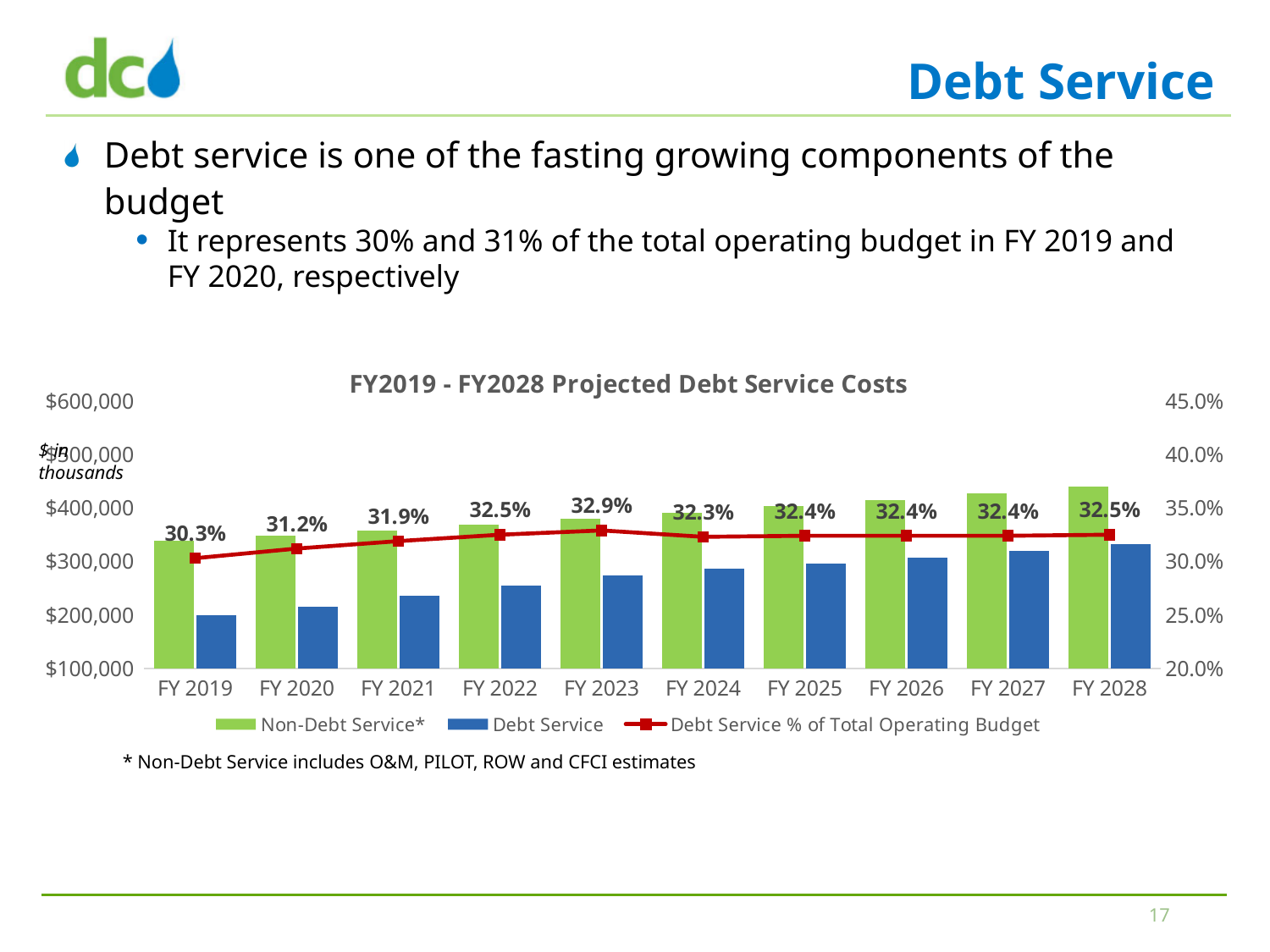
How many fiscal years are shown on the x axis of the chart? 10 What is the difference in Debt Service % of Total Operating Budget between FY 2023 and FY 2019? 2.6 percentage points Does the Debt Service bar series rise or fall from FY 2019 to FY 2028? rise What is the Debt Service % of Total Operating Budget for FY 2019? 30.3% What is the Debt Service % of Total Operating Budget for FY 2028? 32.5% Is the Debt Service value for FY 2023 greater or less than $300,000? less How many series does the chart legend list? 3 What is the Debt Service % of Total Operating Budget for FY 2023? 32.9% Which is larger, the Debt Service % of Total Operating Budget in FY 2022 or in FY 2024? FY 2022 In which fiscal year is the Debt Service % of Total Operating Budget highest? FY 2023 Is the Debt Service value for FY 2028 greater or less than $300,000? greater In which fiscal year is the Debt Service % of Total Operating Budget lowest? FY 2019